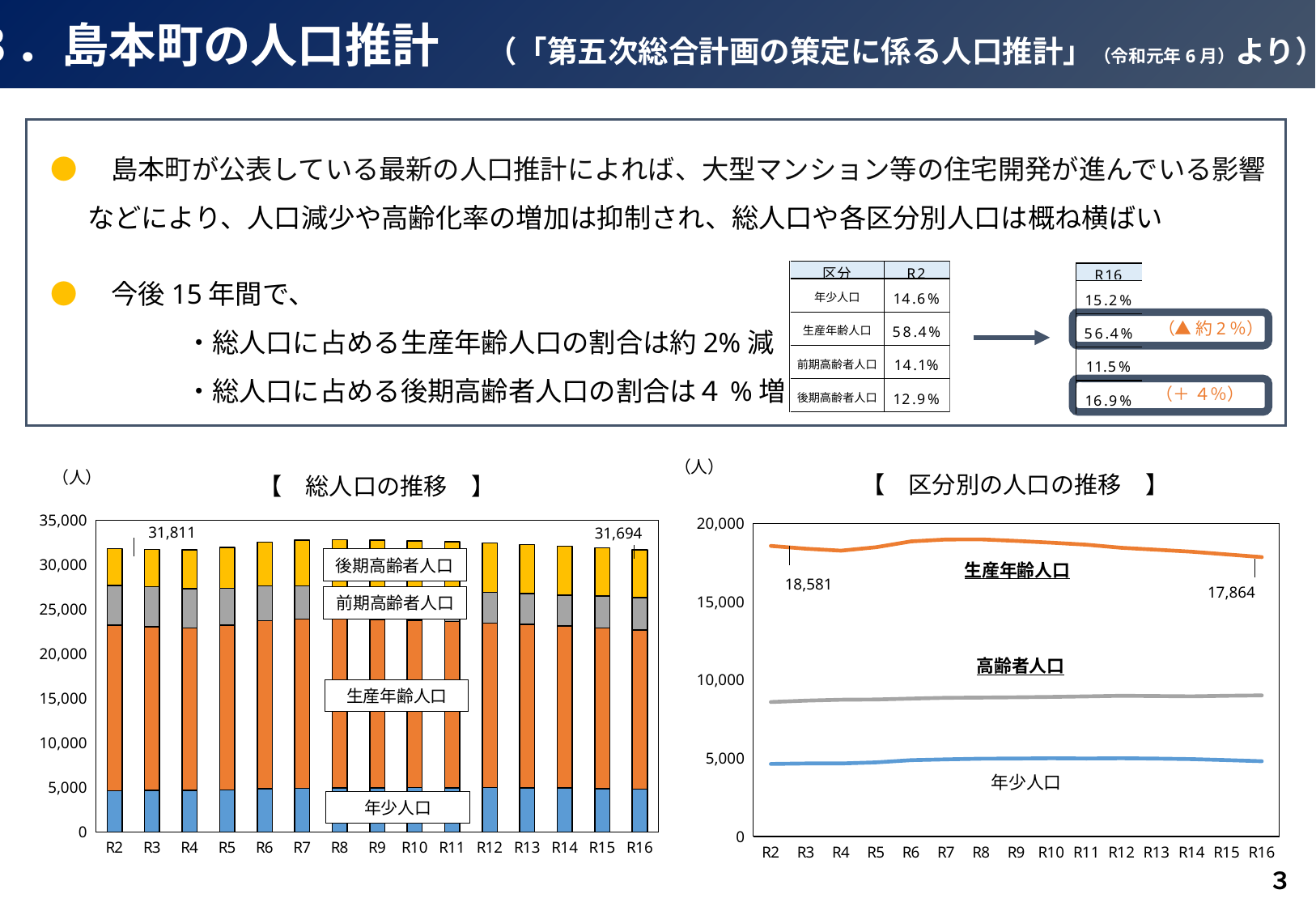
In the right chart (区分別の人口の推移), what is the value of 生産年齢人口 in R2? 18,581 In the left chart (総人口の推移), what is the total population shown for R16? 31,694 In the right chart (区分別の人口の推移), is the value of 高齢者人口 in R2 greater or less than 10,000? less In the left chart (総人口の推移), which year has the larger total population, R2 or R16? R2 What kind of chart is the right chart titled 区分別の人口の推移? line chart What kind of chart is the left chart titled 総人口の推移? bar chart In the left chart (総人口の推移), what is the difference between the total population in R2 and in R16? 117 How many years (categories) are shown on the x axis of the left chart (総人口の推移)? 15 In the right chart (区分別の人口の推移), what is the value of 生産年齢人口 in R16? 17,864 In the right chart (区分別の人口の推移), which population group has the highest line? 生産年齢人口 In the left chart (総人口の推移), what is the total population shown for R2? 31,811 In the right chart (区分別の人口の推移), by how much does 生産年齢人口 decrease from R2 to R16? 717